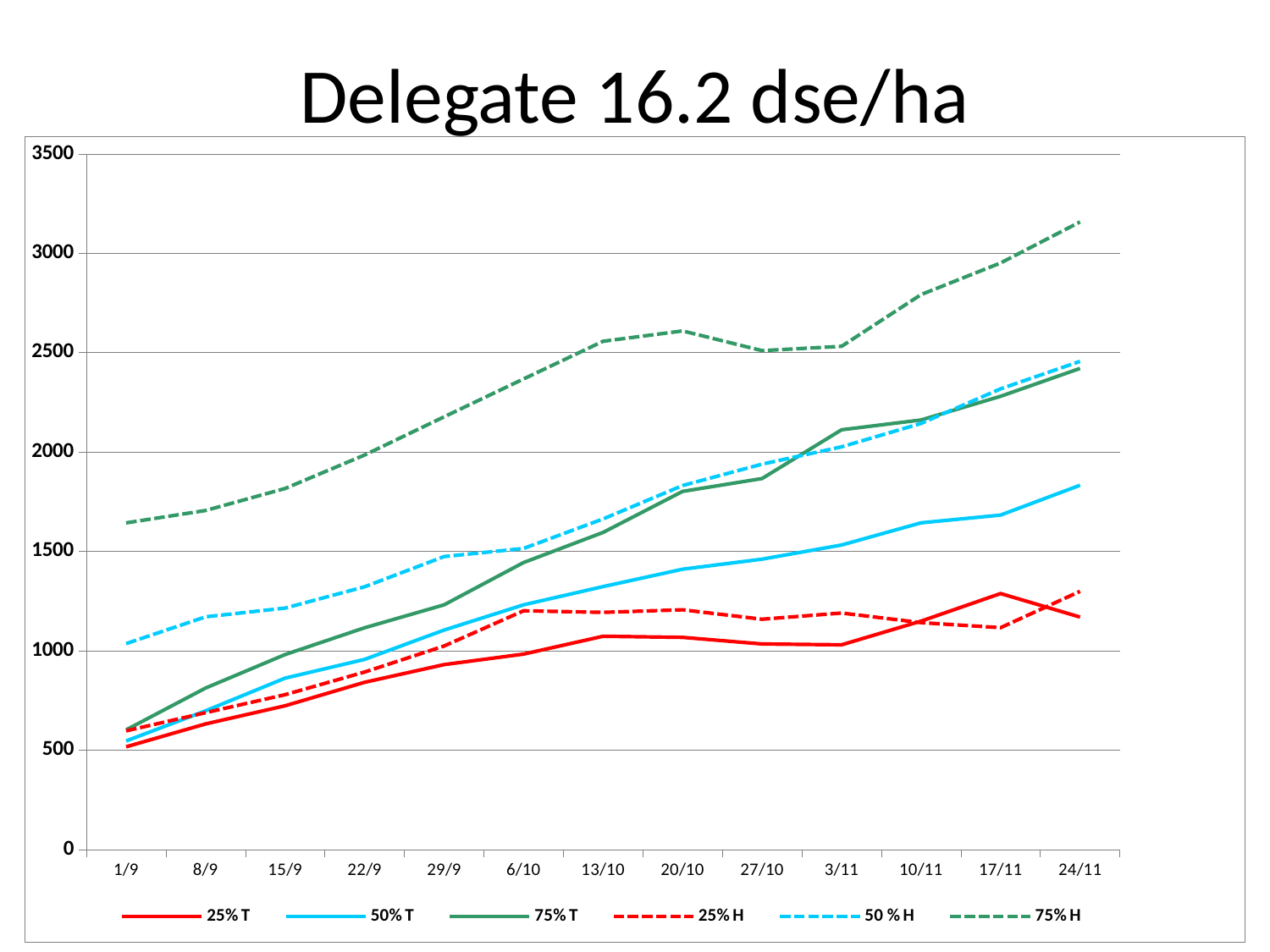
How many dates are shown along the x axis? 13 Which series has the highest value at 24/11? 75% H Is the value for 50% T at 24/11 greater or less than 1500? greater Is the value for 75% T at 13/10 greater or less than 2000? less Is the value for 75% H at 24/11 greater or less than 3000? greater Which series has the lowest value at 3/11? 25% T How many series does the legend list? 6 What kind of chart is shown on the slide? line chart What is the title of the chart? Delegate 16.2 dse/ha Does the 75% H series generally rise or fall from 1/9 to 24/11? rise At 17/11, which is larger, 25% T or 25% H? 25% T